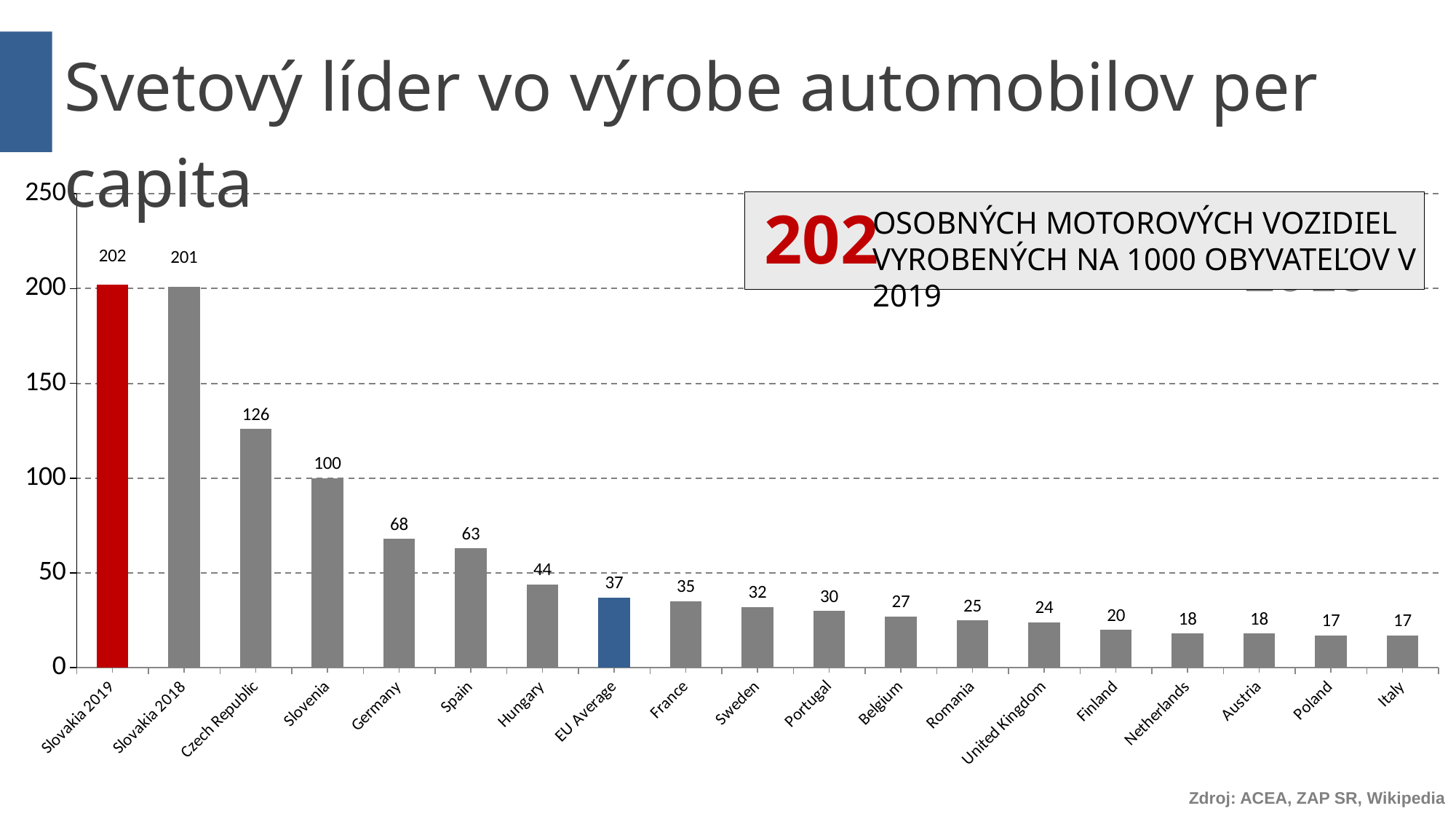
Do the values generally rise or fall from left to right along the x axis? fall What is the difference between the values for Slovakia 2019 and Czech Republic? 76 What kind of chart is shown on the slide? bar chart What is the value for United Kingdom? 24 Which is larger, the value for Hungary or the value for France? Hungary What is the difference between the values for Germany and Spain? 5 Is the value for Slovenia greater or less than 150? less What is the value for Germany? 68 How many categories are shown on the x axis? 19 What is the value for EU Average? 37 What is the value for Czech Republic? 126 What is the value for Slovakia 2018? 201